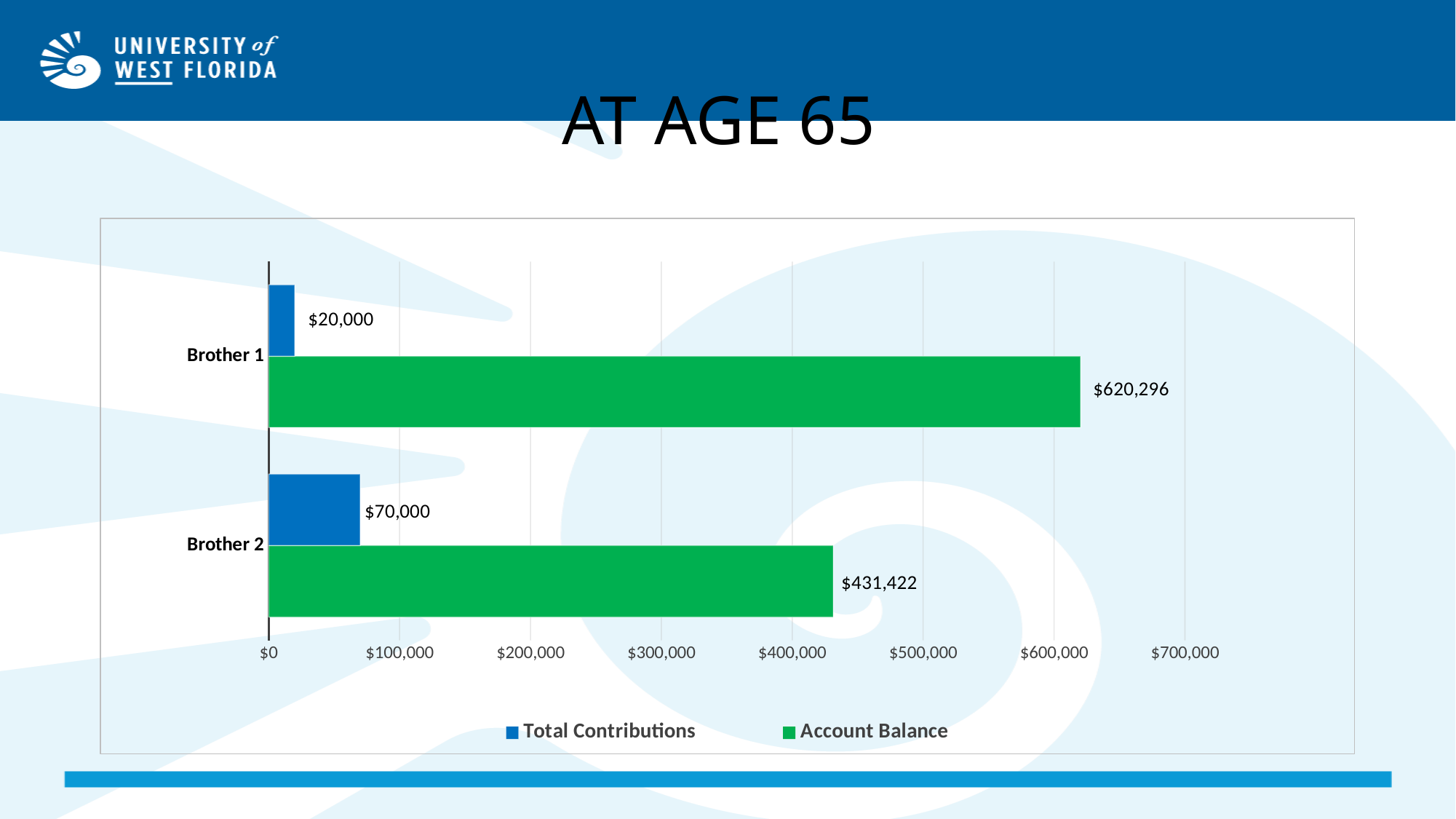
Which colour represents Account Balance in the chart? Green What is the difference between the Account Balance of Brother 1 and Brother 2? $188,874 What is the Account Balance for Brother 2? $431,422 What is the Total Contributions value for Brother 2? $70,000 What kind of chart is shown on the slide? Bar chart What is the Total Contributions value for Brother 1? $20,000 Is the Account Balance for Brother 2 greater or less than $400,000? greater What is the Account Balance for Brother 1? $620,296 How many series does the legend list? 2 Which brother has the lower Total Contributions? Brother 1 Which brother has the higher Account Balance? Brother 1 What is the difference in Total Contributions between Brother 2 and Brother 1? $50,000